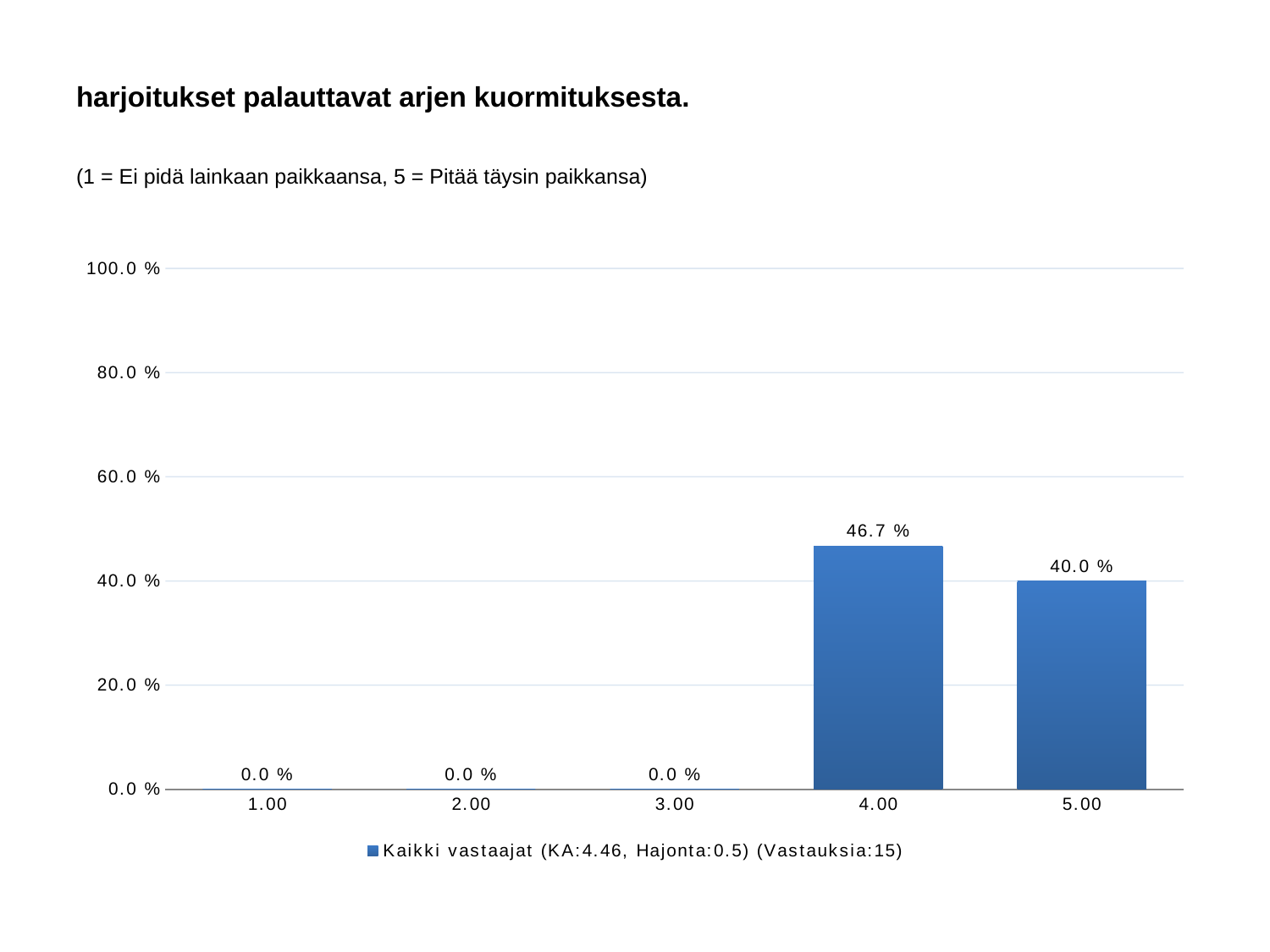
What is the difference between the values for 4.00 and 5.00? 6.7 % What is the value for category 5.00? 40.0 % How many categories are shown on the x axis? 5 How many categories have a value of 0.0 %? 3 Which is larger, the value for 4.00 or the value for 5.00? 4.00 What is the legend entry for the series? Kaikki vastaajat (KA:4.46, Hajonta:0.5) (Vastauksia:15) Is the value for 4.00 greater or less than 60.0 %? less How many series does the legend list? 1 What is the value for category 1.00? 0.0 % Which category has the highest value? 4.00 What kind of chart is shown? bar chart What is the value for category 4.00? 46.7 %